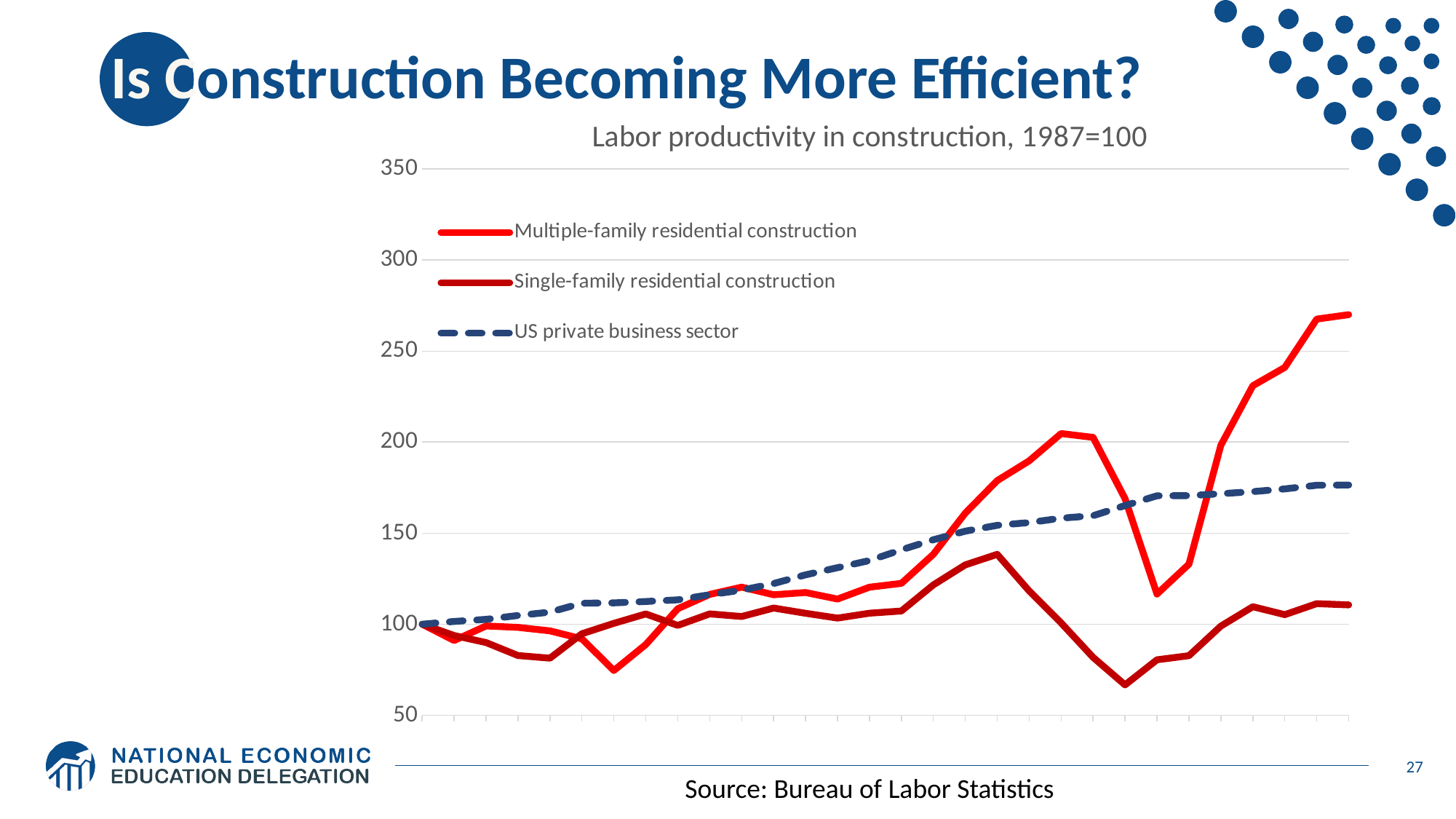
What kind of chart is shown on the slide? line chart Is the highest value reached by Single-family residential construction greater or less than 150? less What index value do all three series share in the base year 1987? 100 At the right end of the chart, which is higher: US private business sector or Single-family residential construction? US private business sector Which series ends at the lowest value at the right end of the chart? Single-family residential construction Is the final value of US private business sector greater or less than 150? greater Is the final value of Multiple-family residential construction greater or less than 250? greater What is the title of the chart? Labor productivity in construction, 1987=100 How many series does the legend list? 3 Which series reaches the highest value anywhere on the chart? Multiple-family residential construction Which series is drawn with a dashed line? US private business sector